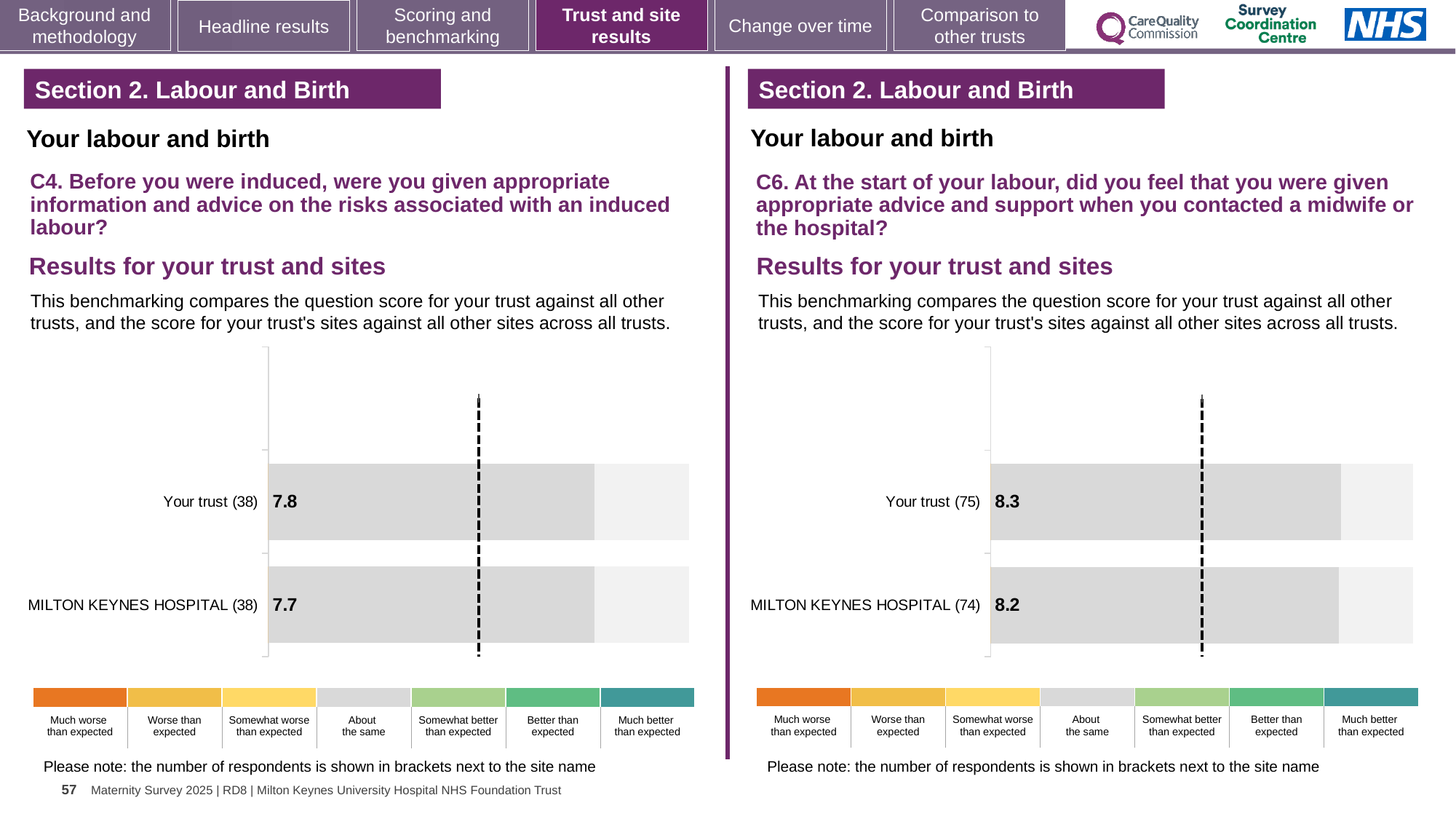
On the right chart (C6), what is the score for Your trust? 8.3 On the right chart (C6), what is the difference between the Your trust score and the MILTON KEYNES HOSPITAL score? 0.1 On the left chart (C4), which has the lower score, Your trust or MILTON KEYNES HOSPITAL? MILTON KEYNES HOSPITAL On the right chart (C6), which has the higher score, Your trust or MILTON KEYNES HOSPITAL? Your trust On the right chart (C6), what is the score for MILTON KEYNES HOSPITAL? 8.2 On the right chart (C6), how many respondents are shown in brackets for Your trust? 75 What type of chart is used on the right side of the slide (C6)? Bar chart On the left chart (C4), what is the difference between the Your trust score and the MILTON KEYNES HOSPITAL score? 0.1 How many bars are plotted on the left chart (C4)? 2 On the left chart (C4), how many respondents are shown in brackets for MILTON KEYNES HOSPITAL? 38 On the left chart (C4), what is the score for Your trust? 7.8 On the left chart (C4), what is the score for MILTON KEYNES HOSPITAL? 7.7